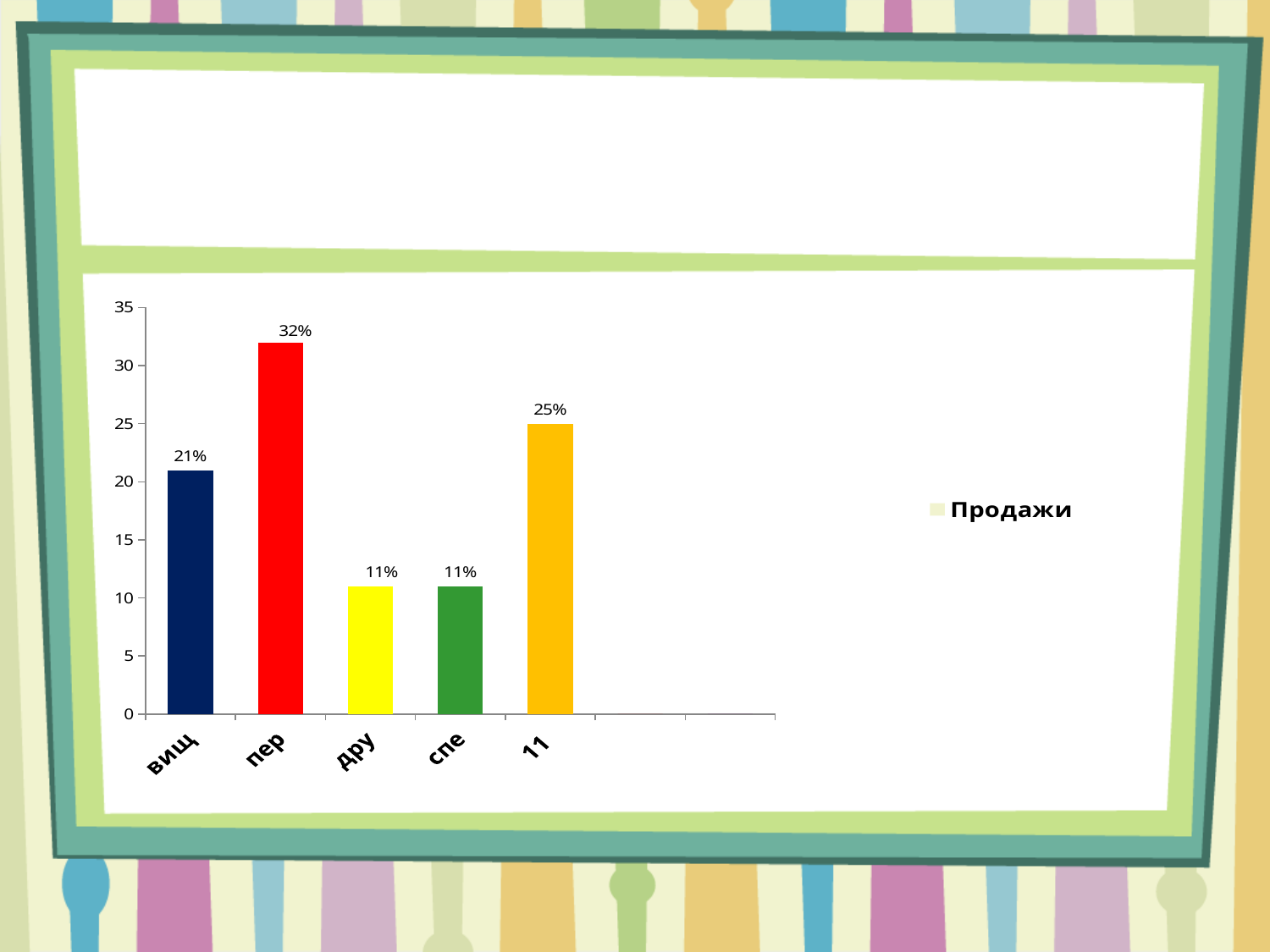
Is the value for "пер" greater or less than 30? greater What is the value for the category "вищ"? 21% What is the value for the category "пер"? 32% What is the value for the category "11"? 25% How many series does the legend list? 1 What kind of chart is shown on the slide? bar chart Which is larger, the value for "вищ" or the value for "11"? 11 What is the name of the series listed in the legend? Продажи How many categories are shown on the x axis? 5 Which category has the highest value? пер What is the difference between the values for "11" and "дру"? 14% What is the difference between the values for "пер" and "вищ"? 11%